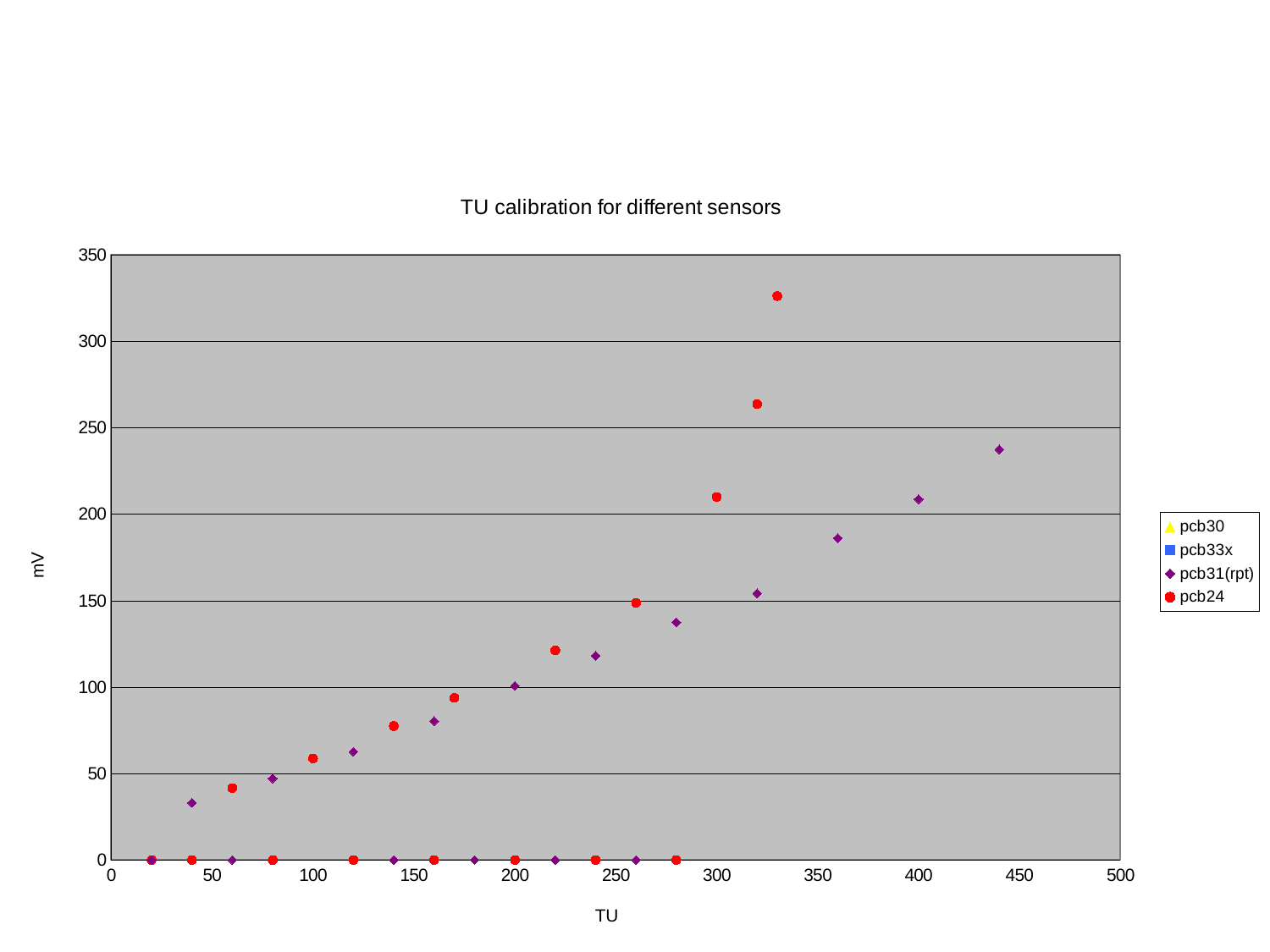
Which series reaches the highest mV value on the chart? pcb24 At TU 320, which series has the higher mV value, pcb24 or pcb31(rpt)? pcb24 Is the pcb31(rpt) value at TU 40 greater or less than 50 mV? less What kind of chart is shown on the slide? scatter chart What is the title of the chart? TU calibration for different sensors How many series does the legend list? 4 Do the pcb24 values rise or fall as TU increases? rise What label is shown on the vertical axis of the chart? mV Is the pcb31(rpt) value at TU 160 greater or less than 100 mV? less Is the pcb31(rpt) value at TU 440 greater or less than 250 mV? less